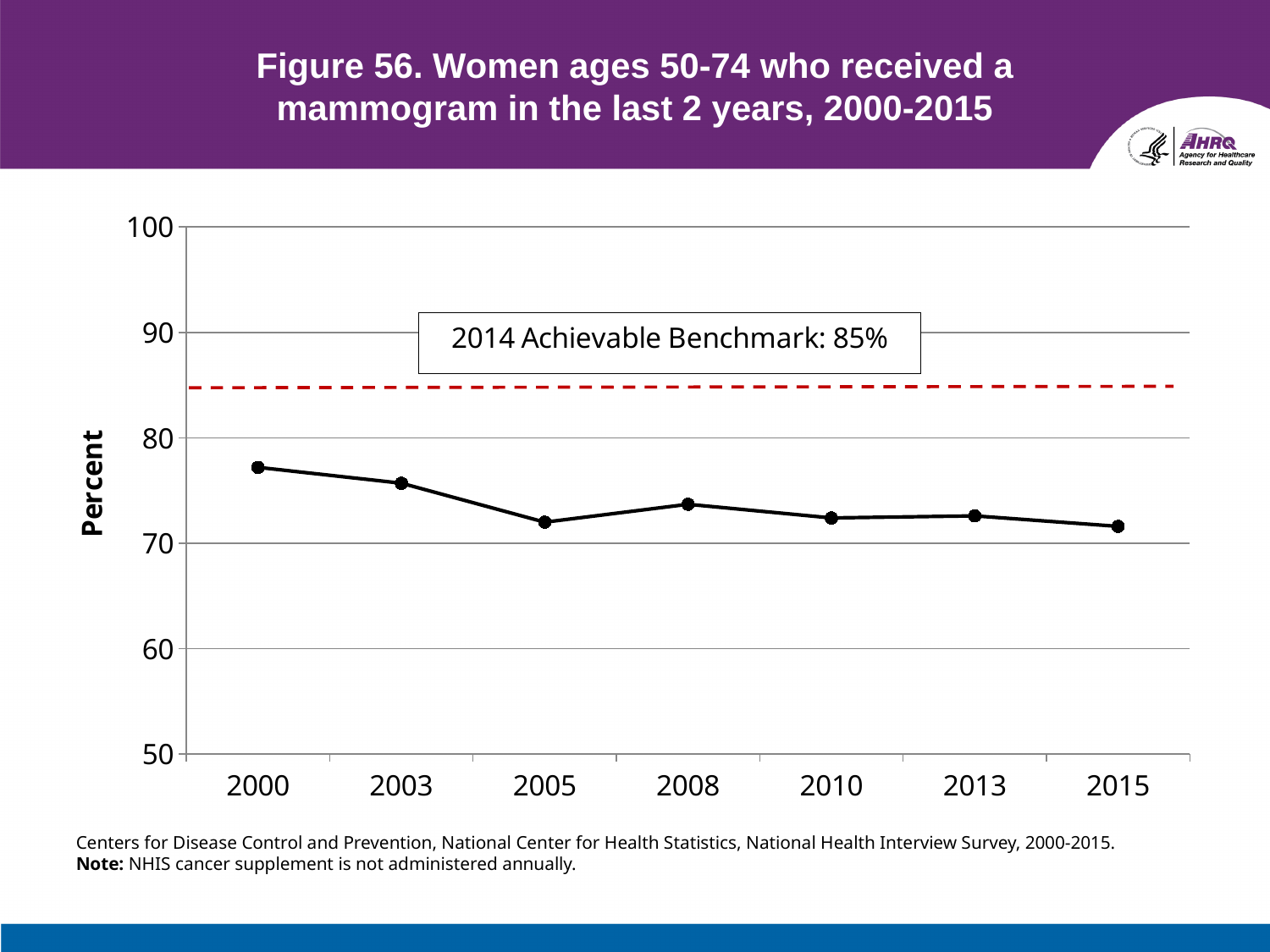
Which year has the highest percentage of women ages 50-74 who received a mammogram? 2000 How is the 2014 Achievable Benchmark drawn on the chart? as a red dashed horizontal line Is the value for 2000 greater or less than 80? less Which is larger, the value for 2000 or the value for 2015? 2000 Is the value for 2015 greater or less than 80? less Do the values generally rise or fall from 2000 to 2015? fall What kind of chart is shown on the slide? line chart What is the 2014 Achievable Benchmark shown on the chart? 85% How many years are plotted on the x axis? 7 What is the label on the y axis? Percent Is the value for 2005 greater or less than 70? greater Which is larger, the value for 2003 or the value for 2005? 2003